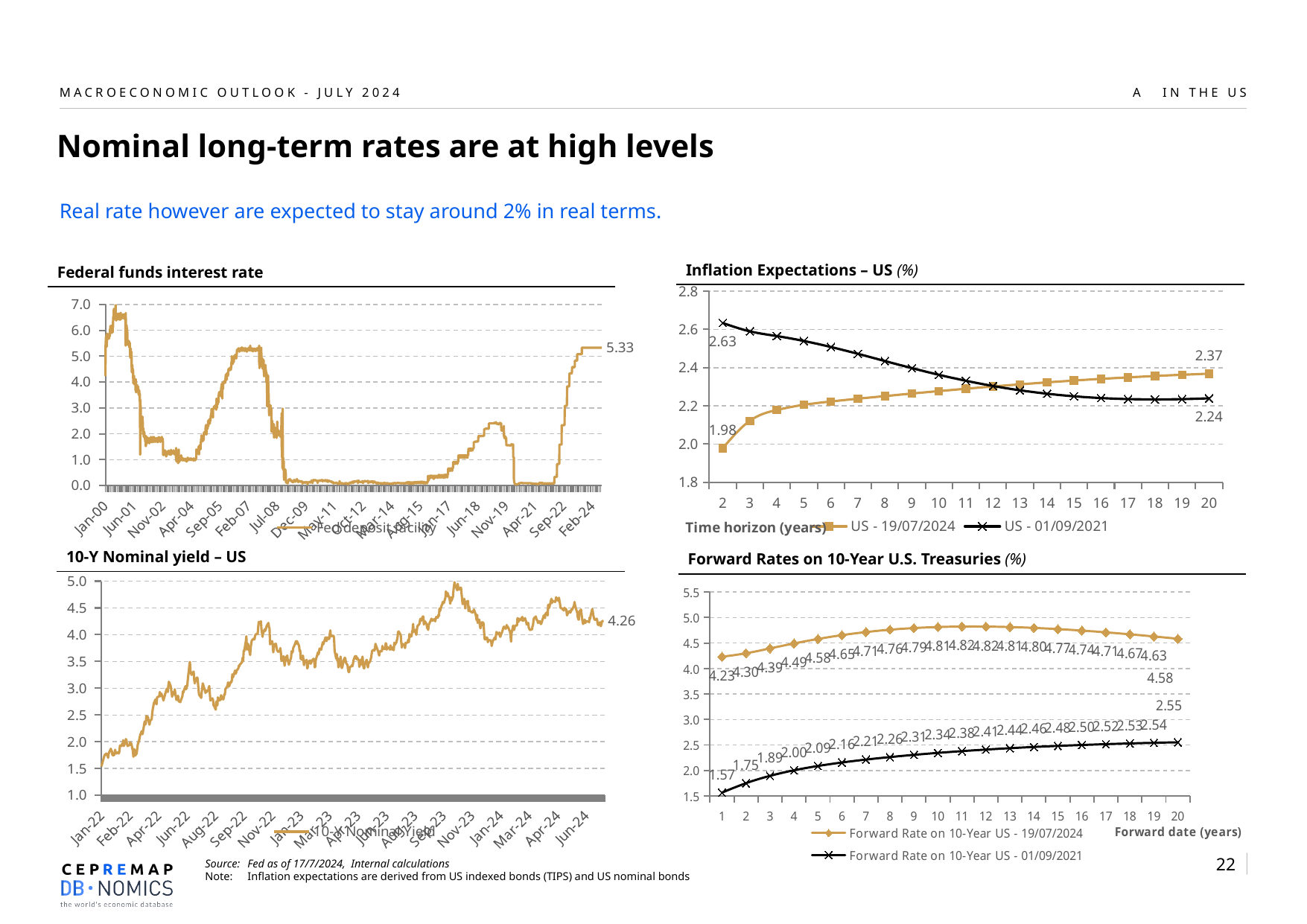
On the 10-Y Nominal yield – US chart, what is the latest value labelled at the end of the line? 4.26 How many series does the legend of the Inflation Expectations – US chart list? 2 On the Forward Rates on 10-Year U.S. Treasuries chart, what is the Forward Rate on 10-Year US - 01/09/2021 at a forward date of 1 year? 1.57 On the Inflation Expectations – US chart, what is the difference between the two series at a time horizon of 2 years (2.63 vs 1.98)? 0.65 On the Federal funds interest rate chart, what is the latest value labelled at the end of the line? 5.33 On the Forward Rates on 10-Year U.S. Treasuries chart, what is the difference between the 19/07/2024 and 01/09/2021 forward rates at a forward date of 20 years? 2.03 On the Inflation Expectations – US chart, what is the value of the US - 01/09/2021 series at a time horizon of 20 years? 2.24 On the 10-Y Nominal yield – US chart, is the value at Jan-22 greater or less than 2.0? less What kind of chart is the Federal funds interest rate chart? line chart On the Inflation Expectations – US chart, what is the value of the US - 19/07/2024 series at a time horizon of 2 years? 1.98 On the Inflation Expectations – US chart, does the US - 01/09/2021 series rise or fall as the time horizon increases? fall How many forward dates (points) are plotted on the x axis of the Forward Rates on 10-Year U.S. Treasuries chart? 20